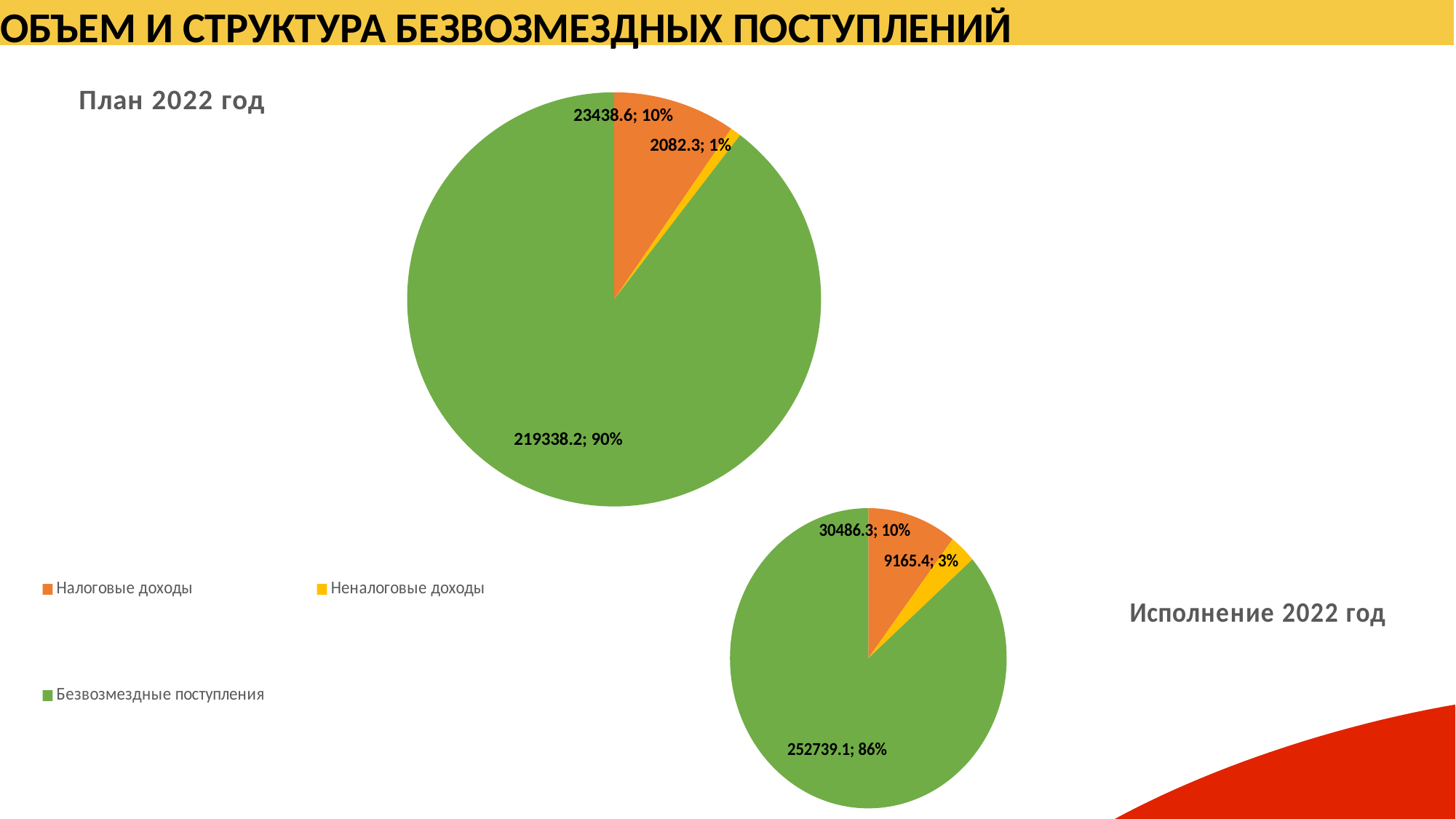
In the 'План 2022 год' chart, what share of the pie is Налоговые доходы? 10% In the 'Исполнение 2022 год' chart, which category has the largest slice? Безвозмездные поступления In the 'План 2022 год' chart, what value is shown for Неналоговые доходы? 2082.3 In the 'План 2022 год' chart, which is larger: Налоговые доходы or Неналоговые доходы? Налоговые доходы In the 'Исполнение 2022 год' chart, what share of the pie is Неналоговые доходы? 3% In the 'Исполнение 2022 год' chart, what share of the pie is Безвозмездные поступления? 86% In the 'План 2022 год' chart, what value is shown for Безвозмездные поступления? 219338.2 In the 'Исполнение 2022 год' chart, what value is shown for Налоговые доходы? 30486.3 What type of chart is 'Исполнение 2022 год'? Pie chart In the 'Исполнение 2022 год' chart, what is the difference between the values for Налоговые доходы and Неналоговые доходы? 21320.9 How many categories does the legend list? 3 In the 'План 2022 год' chart, which category has the smallest slice? Неналоговые доходы